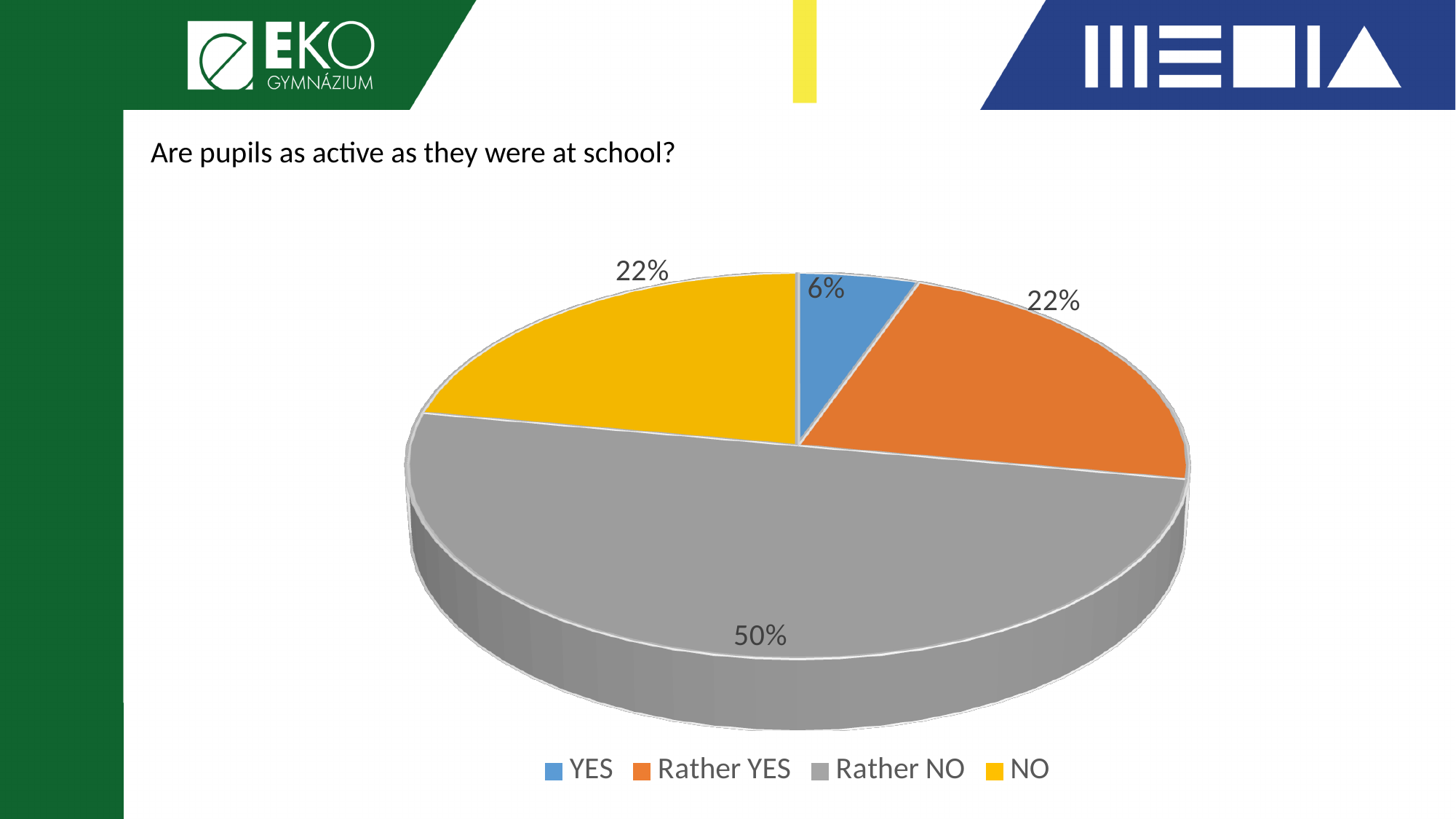
Which category has the largest slice? Rather NO What share of the pie does "Rather NO" take? 50% What colour is the "Rather NO" slice? grey Which is larger, the value for "Rather NO" or the value for "NO"? Rather NO How many categories does the pie chart have? 4 Which category has the smallest slice? YES What is the value for "YES"? 6% What is the difference between the "Rather NO" and "YES" values? 44% What is the value for "NO"? 22% What is the difference between the "Rather YES" and "YES" values? 16% What kind of chart is shown on the slide? pie chart What is the value for "Rather YES"? 22%